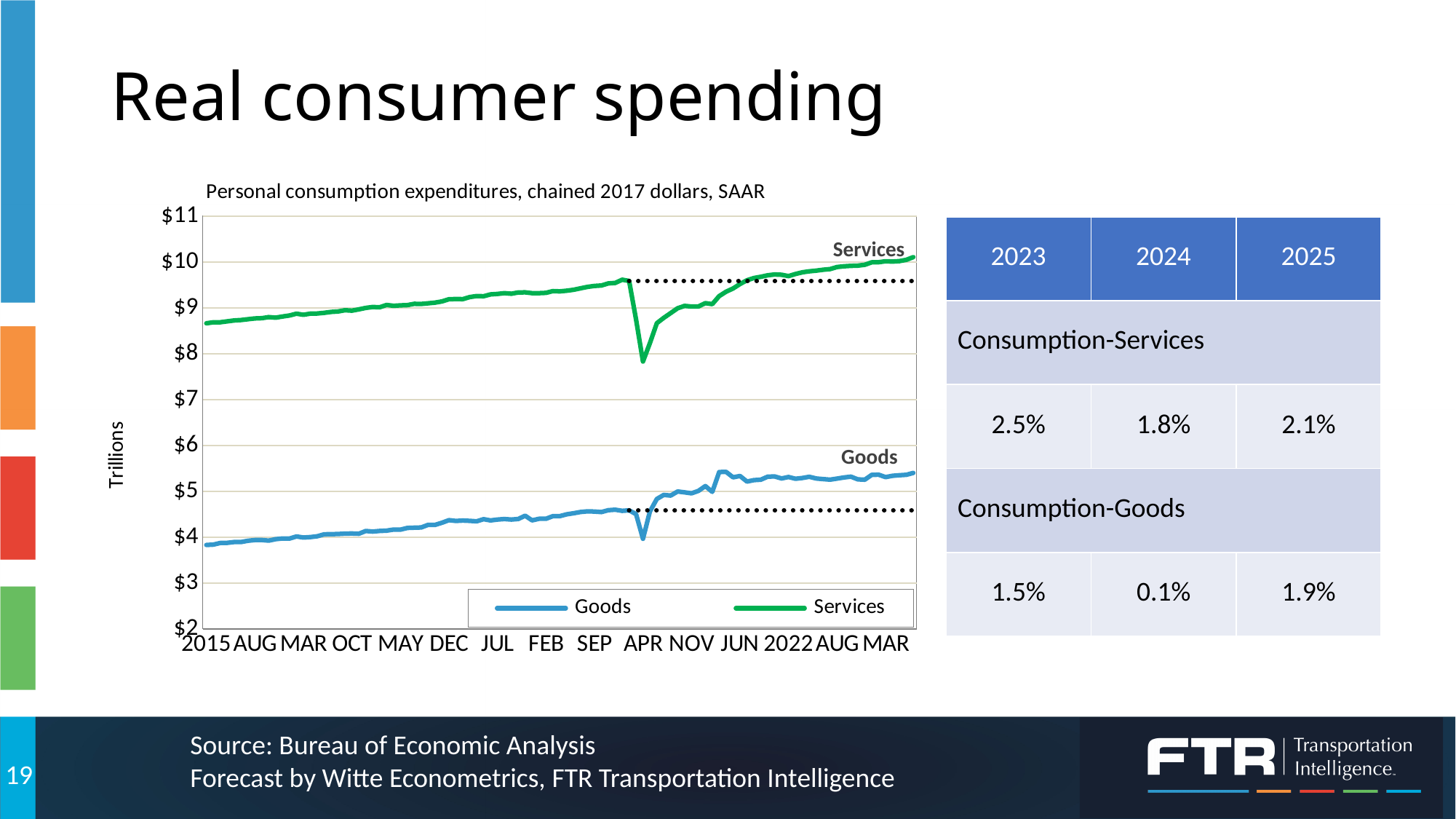
What is the title of the chart? Personal consumption expenditures, chained 2017 dollars, SAAR What is the label on the chart's vertical axis? Trillions Is the value for Services at the end of the chart (MAR) greater or less than $9? greater Is the value for Goods at the end of the chart (MAR) greater or less than $5? greater What kind of chart is shown on the slide? line chart Is the value for Services at the start of the chart (2015) greater or less than $8? greater Which series has higher values throughout the chart, Goods or Services? Services Which series reaches the highest value on the chart? Services How many series does the chart's legend list? 2 Overall, do the Goods values rise or fall from 2015 to the end of the chart? rise